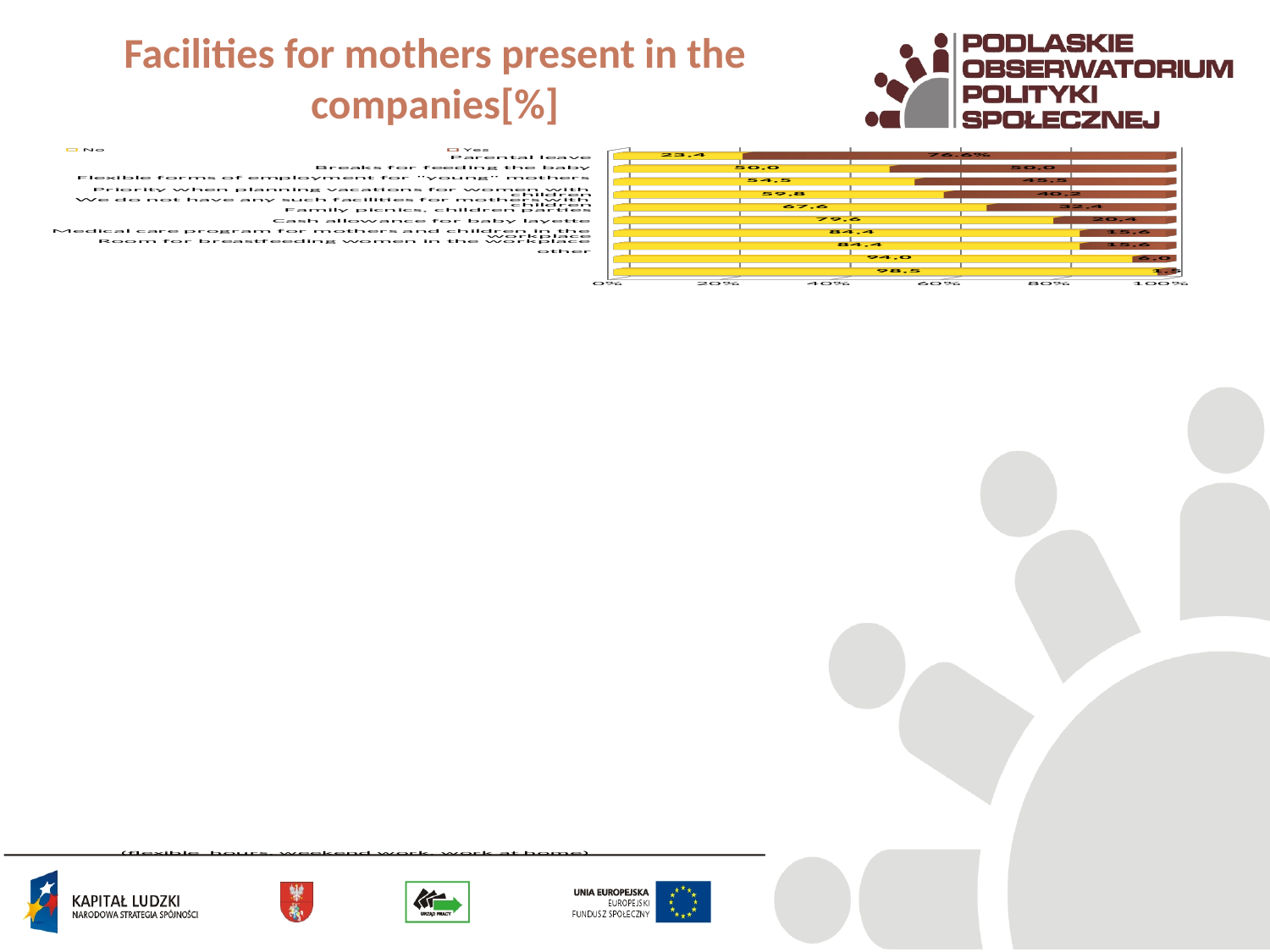
What is the "No" value for Flexible forms of employment for "young" mothers? 54.5 What is the difference between the "No" value for Parental leave and the "No" value for Breaks for feeding the baby? 26.6 What is the "No" value for Room for breastfeeding women in the workplace? 94.0 What is the "Yes" value for Parental leave? 76.6% What are the two series named in the chart legend? No and Yes What is the "Yes" value for Priority when planning vacations for women with children? 40.2 Which facility has the highest "Yes" value? Parental leave How many series does the chart legend list? 2 Which is larger, the "Yes" value for Family picnics, children parties or the "Yes" value for Cash allowance for baby layette? Family picnics, children parties What is the "No" value for Parental leave? 23.4 What is the "Yes" value for Breaks for feeding the baby? 50.0 What kind of chart is shown on the slide? bar chart